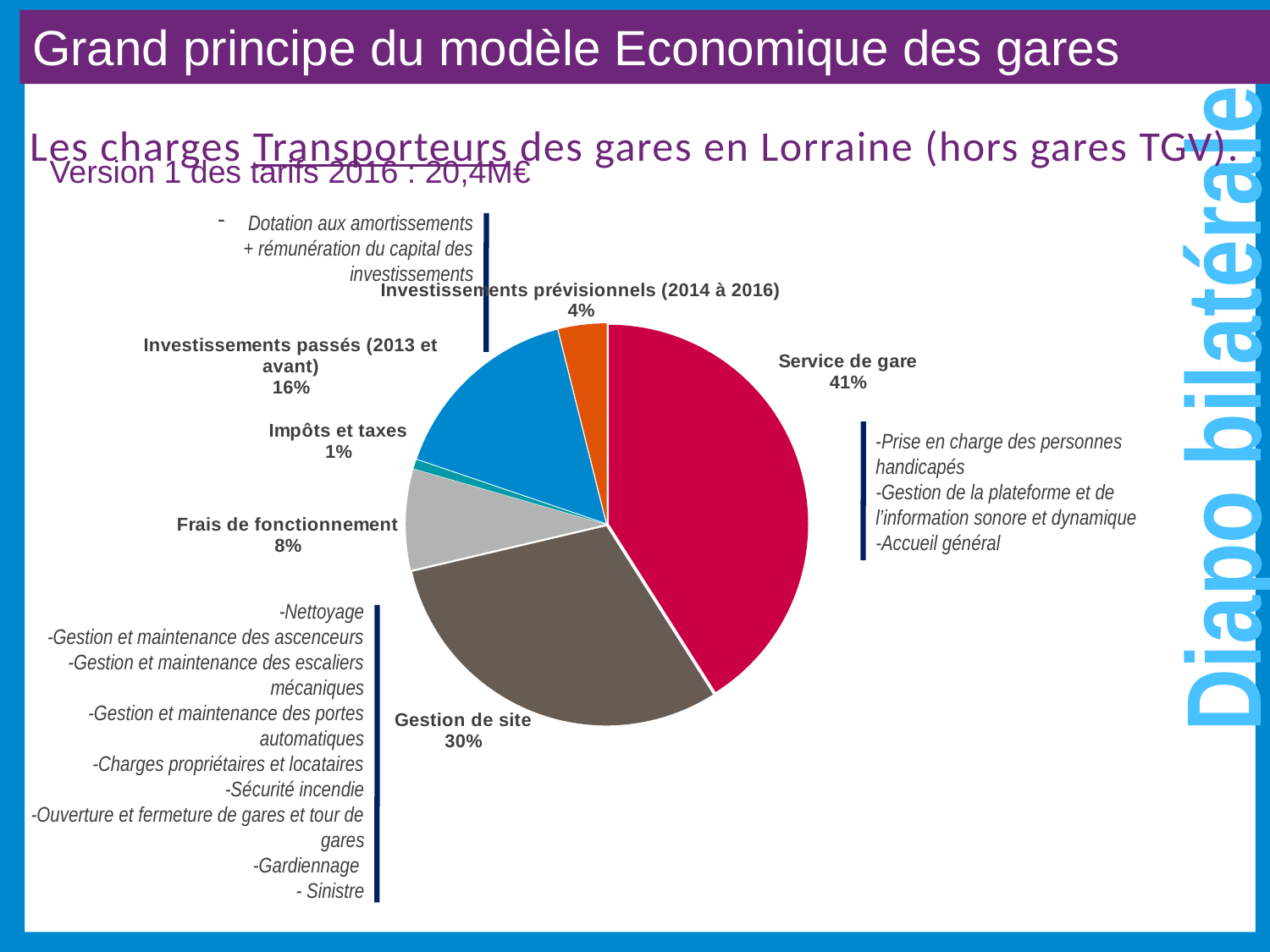
What is the value for Frais de fonctionnement? 8% Which is larger, Investissements passés (2013 et avant) or Frais de fonctionnement? Investissements passés (2013 et avant) What colour is the Service de gare slice? Red Which category has the largest share of the pie? Service de gare What percentage is shown for Gestion de site? 30% Which category has the smallest share of the pie? Impôts et taxes How many slices does the pie chart have? 6 What is the value for Investissements prévisionnels (2014 à 2016)? 4% What type of chart is shown on the slide? Pie chart What percentage is labelled for Investissements passés (2013 et avant)? 16% What is the difference in percentage points between Service de gare and Gestion de site? 11 What share of the pie does Service de gare represent? 41%